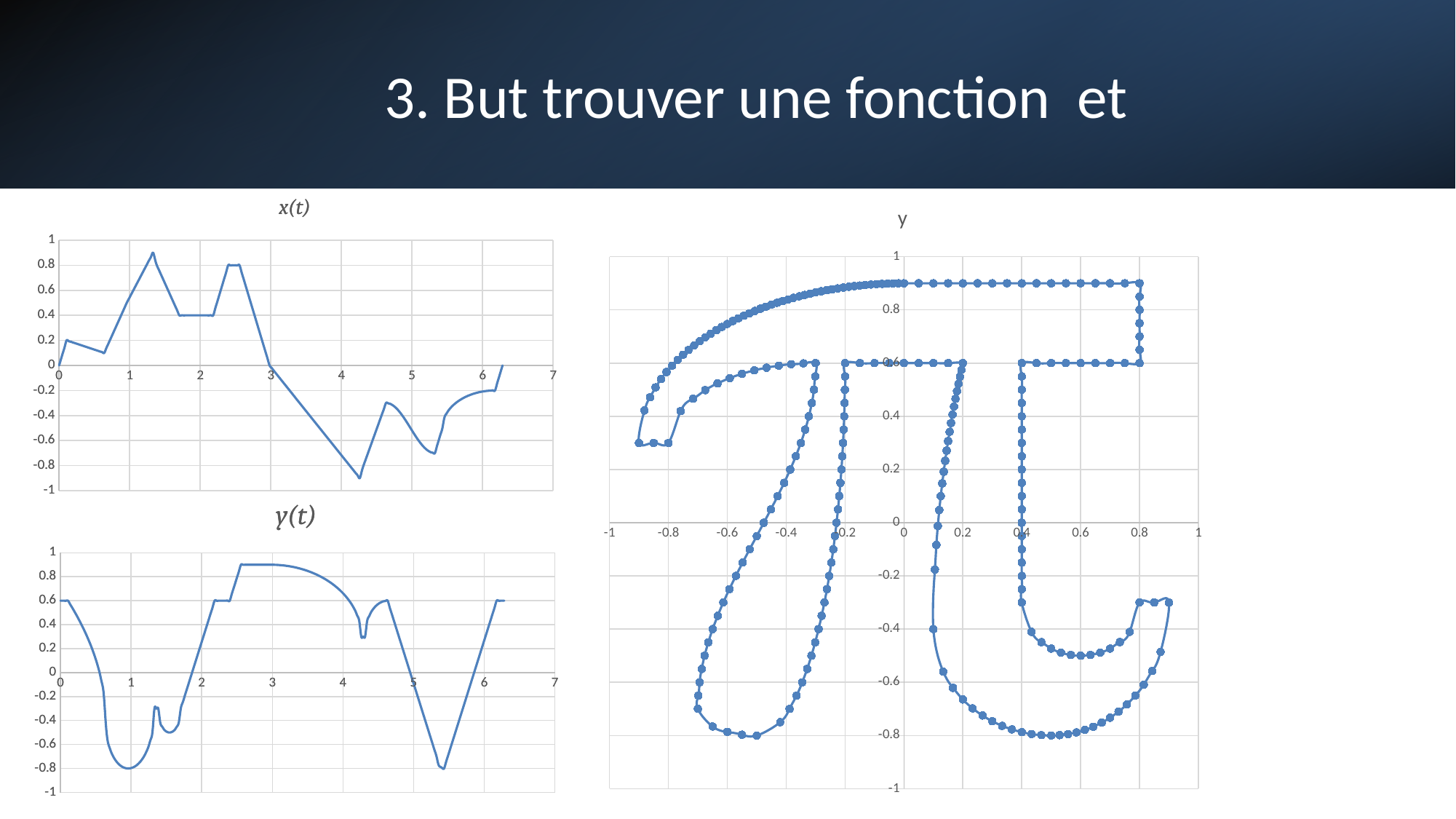
What kind of chart is the chart titled "y" on the right? scatter chart What kind of chart is the x(t) chart on the left? line chart In the y(t) chart, is the value at t = 1 greater or less than -0.6? less In the x(t) chart, what is the value of x(t) at t = 0? 0 In the x(t) chart, is the value at t = 4 greater or less than -0.4? less In the x(t) chart, does the curve rise or fall between t = 3 and t = 4? fall In the y(t) chart, is the value at t = 3 greater or less than 0.8? greater In the y(t) chart, does the curve rise or fall between t = 5.5 and t = 6? rise What symbol do the plotted points in the right-hand chart titled "y" form? π (pi) In the y(t) chart, what is the lowest value reached by the curve? -0.8 In the y(t) chart, what is the value of y(t) at t = 0? 0.6